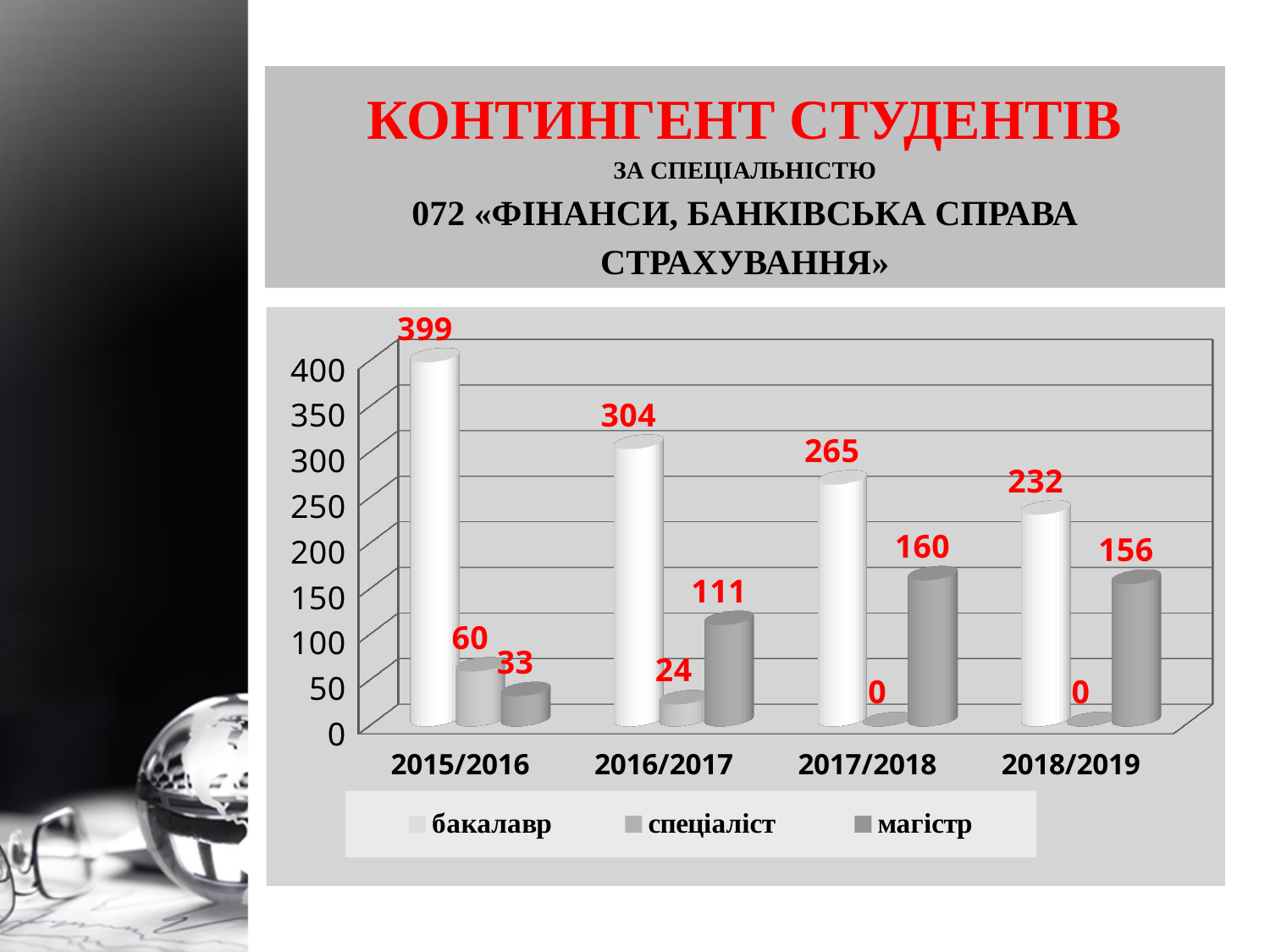
How many series does the legend list? 3 What is the value for спеціаліст in 2016/2017? 24 Do the бакалавр values rise or fall from 2015/2016 to 2018/2019? fall What is the difference between the бакалавр values for 2015/2016 and 2016/2017? 95 What kind of chart is shown on the slide? bar chart Which academic year has the lowest value for магістр? 2015/2016 What is the value for бакалавр in 2015/2016? 399 Which academic year has the highest value for бакалавр? 2015/2016 What is the value for магістр in 2017/2018? 160 What is the value for спеціаліст in 2018/2019? 0 Which is larger: магістр in 2017/2018 or магістр in 2018/2019? магістр in 2017/2018 How many academic years are shown on the x axis? 4